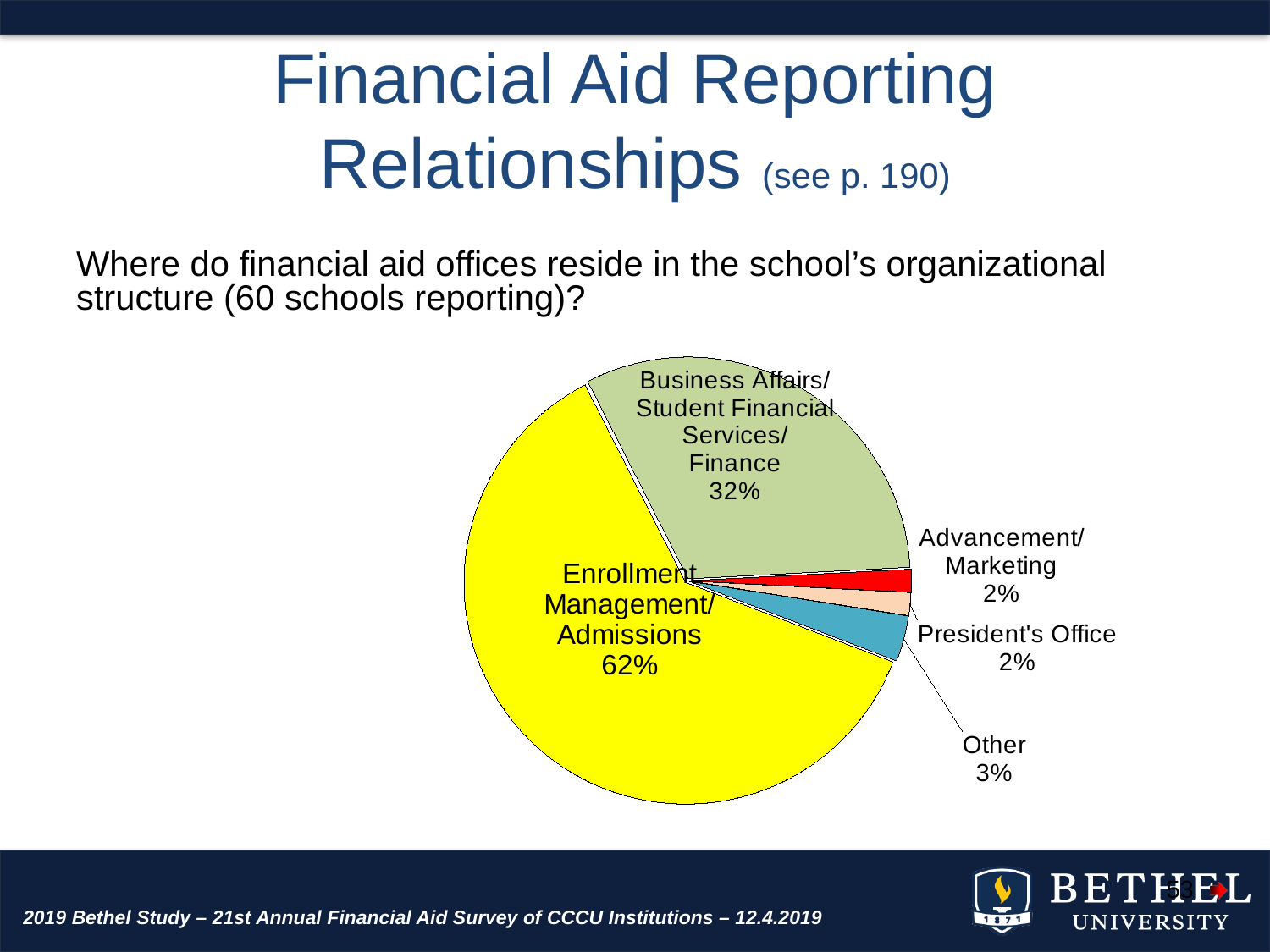
What colour is the Enrollment Management/Admissions slice? yellow Which is larger, the Other slice or the President's Office slice? Other Which category has the largest slice of the pie? Enrollment Management/Admissions What share of the pie is Advancement/Marketing? 2% What share of the pie is Enrollment Management/Admissions? 62% What share of the pie is President's Office? 2% How many slices does the pie chart have? 5 How many schools reported, according to the text above the chart? 60 What is the difference in percentage points between Enrollment Management/Admissions and Business Affairs/Student Financial Services/Finance? 30 What kind of chart is shown on the slide? pie chart